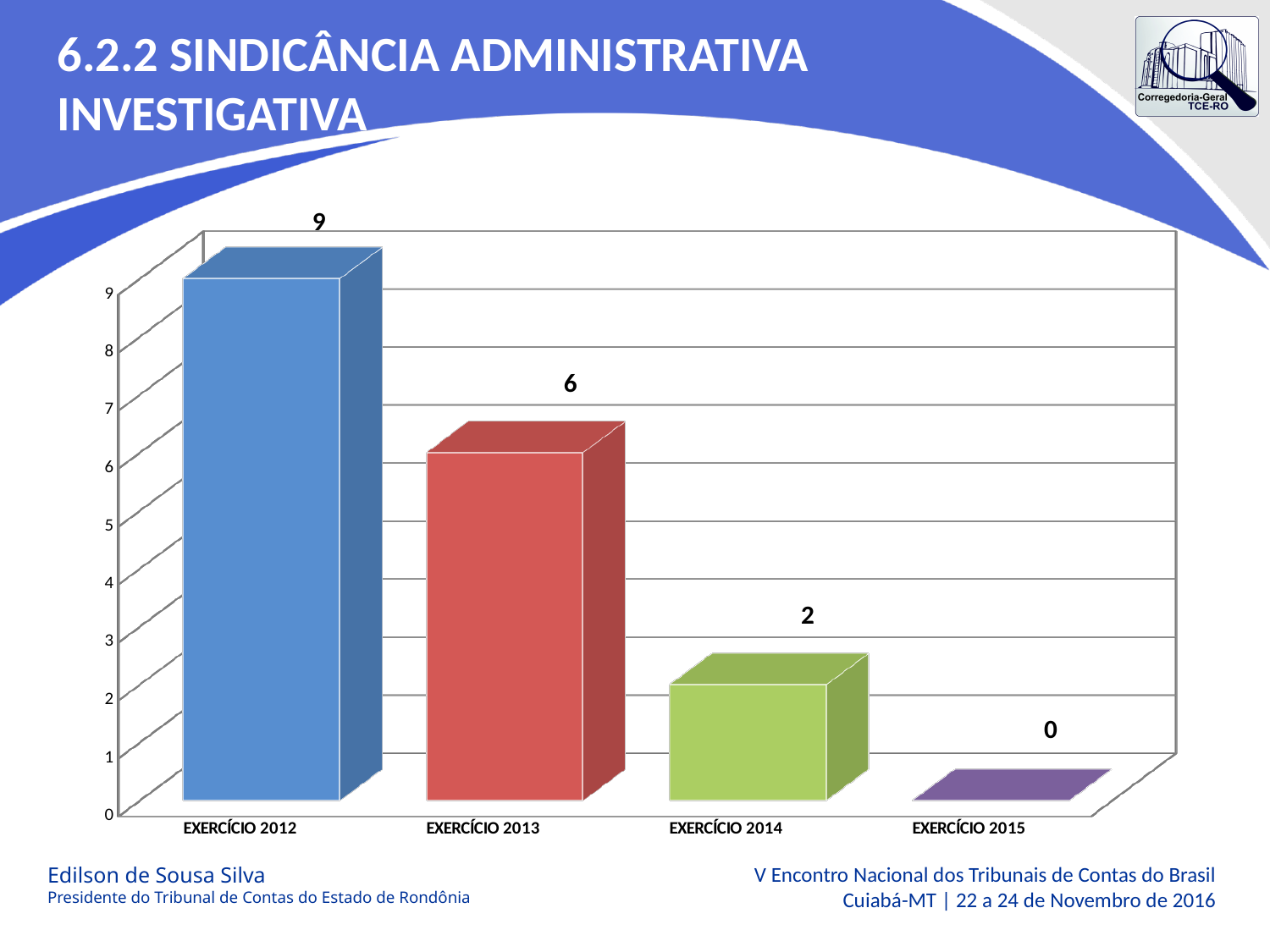
What is the value for EXERCÍCIO 2013? 6 What is the difference between the values for EXERCÍCIO 2012 and EXERCÍCIO 2013? 3 Which category has the highest value? EXERCÍCIO 2012 What is the value for EXERCÍCIO 2012? 9 How many categories are shown on the x axis? 4 Do the values rise or fall from EXERCÍCIO 2012 to EXERCÍCIO 2015? Fall Which category has the lowest value? EXERCÍCIO 2015 What is the difference between the values for EXERCÍCIO 2013 and EXERCÍCIO 2014? 4 What is the value for EXERCÍCIO 2015? 0 What is the value for EXERCÍCIO 2014? 2 What kind of chart is shown on the slide? Bar chart Which is larger, the value for EXERCÍCIO 2013 or the value for EXERCÍCIO 2014? EXERCÍCIO 2013